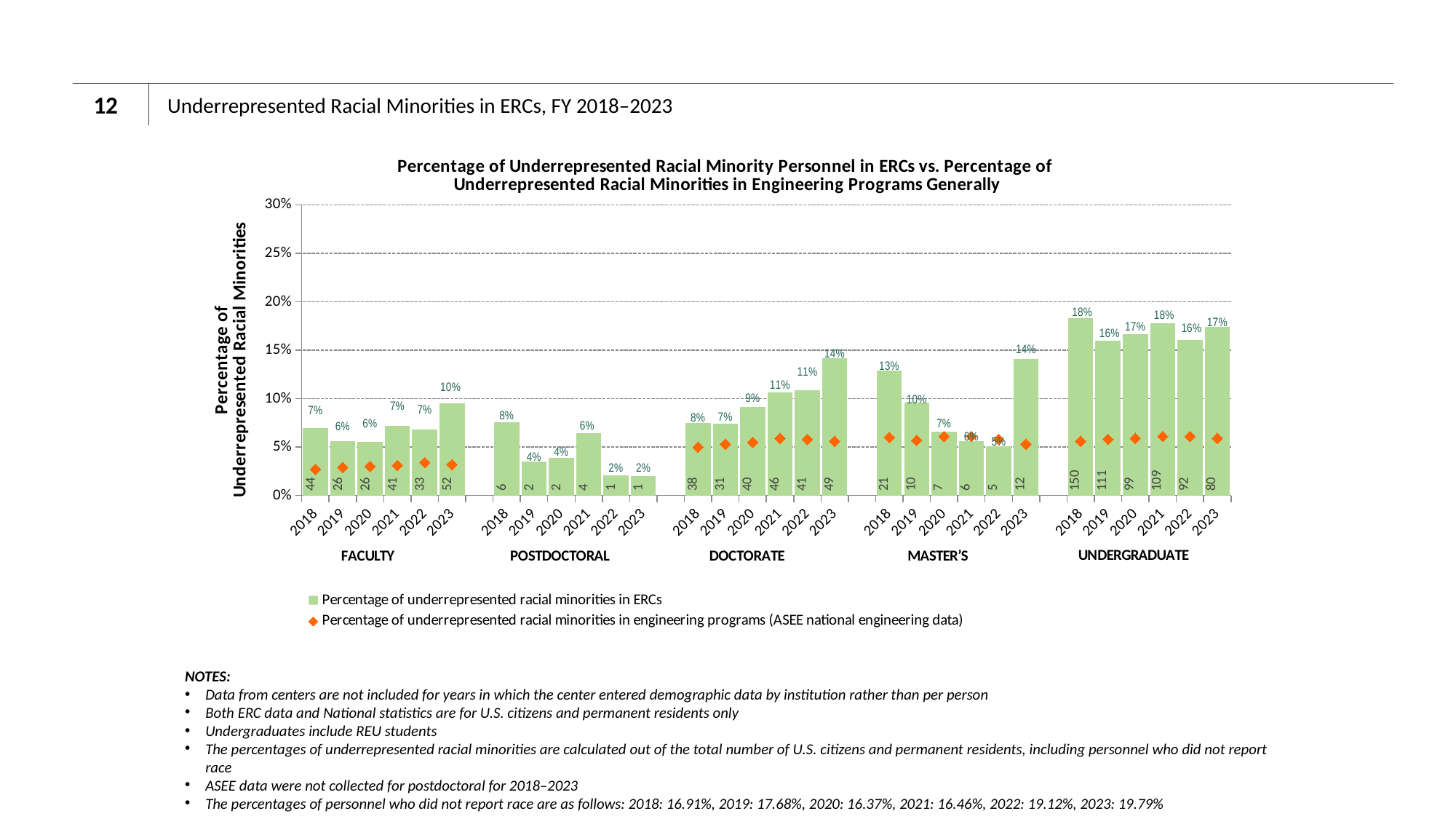
What kind of chart is used to show the percentage of underrepresented racial minorities in ERCs? Bar chart How many series does the legend list? 2 What is the percentage of underrepresented racial minorities in ERCs for Doctorate in 2021? 11% How many personnel groups are shown along the x axis? 5 Is the Undergraduate 2021 bar for underrepresented racial minorities in ERCs greater or less than 15%? greater Which year has the highest percentage of underrepresented racial minorities in ERCs within the Master's group? 2023 Which year has the lowest percentage of underrepresented racial minorities in ERCs within the Doctorate group? 2019 What is the count label shown on the Undergraduate bar for 2018? 150 Do the Postdoctoral percentages of underrepresented racial minorities in ERCs generally rise or fall from 2018 to 2023? Fall What is the difference between the Undergraduate 2018 percentage and the Undergraduate 2019 percentage of underrepresented racial minorities in ERCs? 2% What is the percentage of underrepresented racial minorities in ERCs for Faculty in 2023? 10% Which is larger: the Master's 2018 percentage or the Doctorate 2018 percentage of underrepresented racial minorities in ERCs? Master's 2018